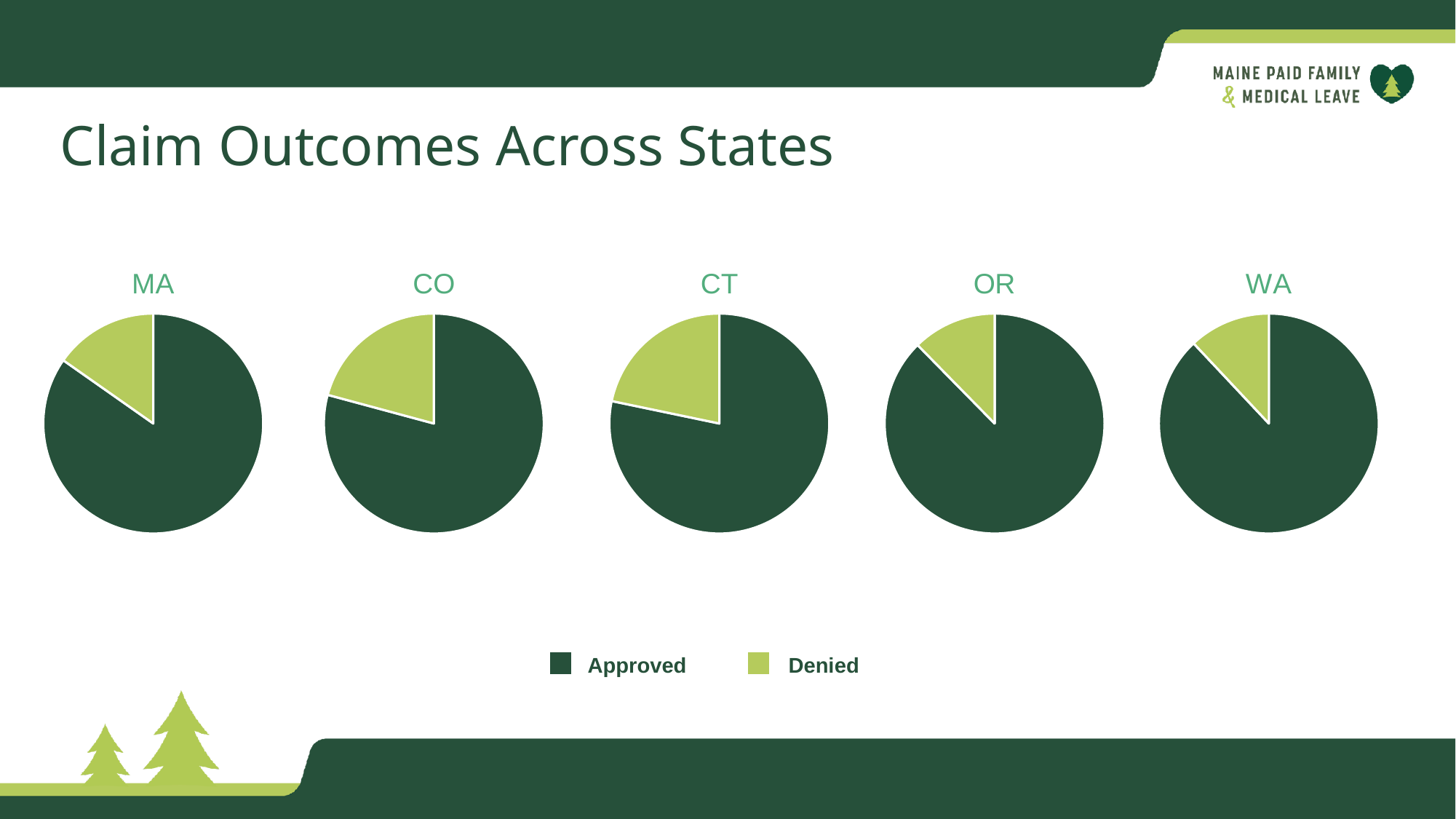
In the MA pie chart, which is larger, the Approved slice or the Denied slice? Approved Which states are shown as pie charts on the slide? MA, CO, CT, OR, WA What kind of charts are shown on the slide? Pie charts In the CT pie chart, which is larger, the Approved slice or the Denied slice? Approved Which has the larger Denied slice, the CO pie chart or the WA pie chart? CO What is the title of the slide containing the pie charts? Claim Outcomes Across States Which state's pie chart has the largest Denied slice? CT How many pie charts are shown on the slide? 5 How many categories does the legend list for the pie charts? 2